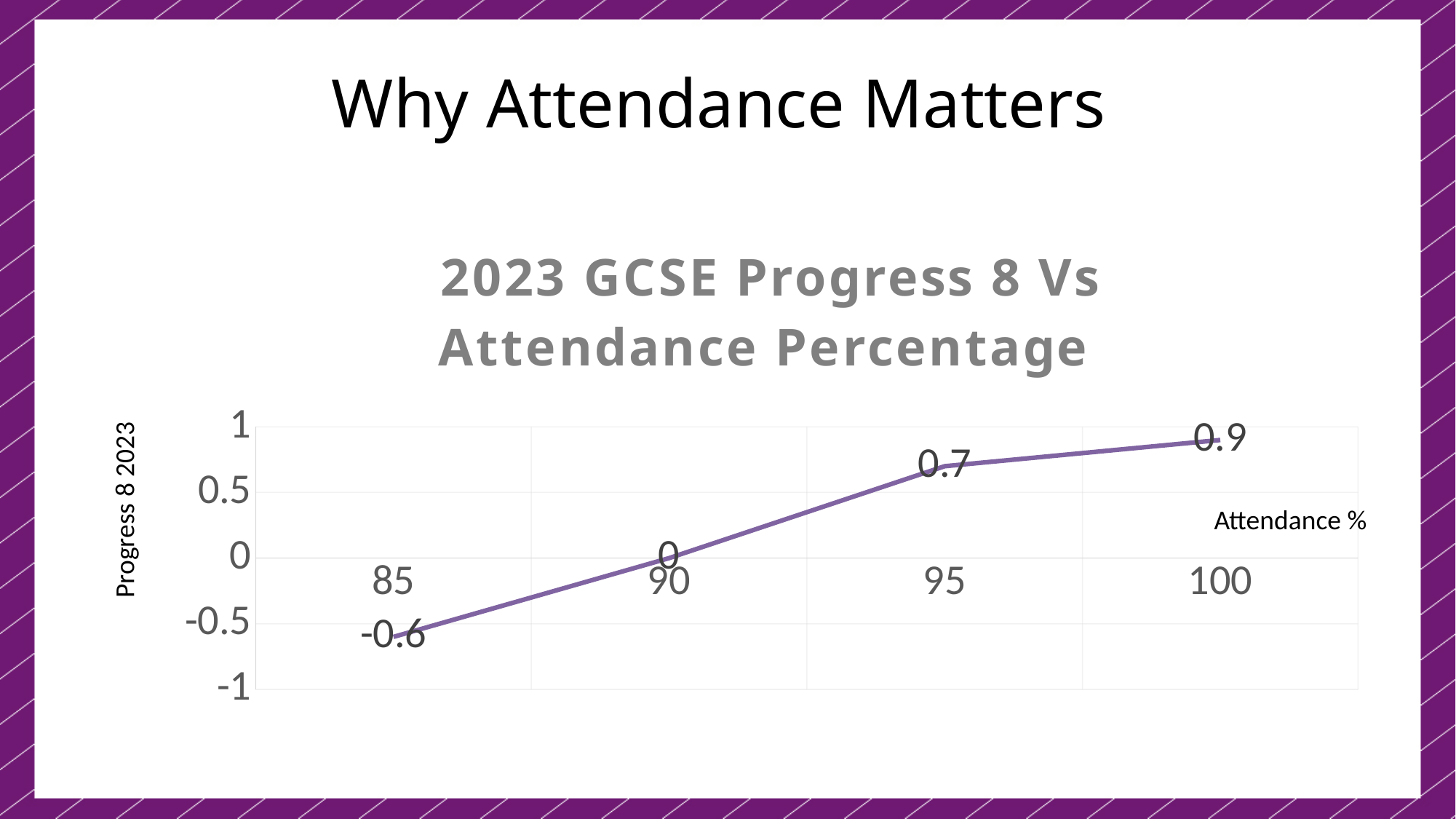
What kind of chart is shown on the slide? Line chart What is the difference between the Progress 8 values at 95% and 90% attendance? 0.7 Which attendance percentage has the lowest Progress 8 value? 85 Which has a larger Progress 8 value, 90% attendance or 95% attendance? 95 What is the difference between the Progress 8 values at 100% and 85% attendance? 1.5 Do the Progress 8 values rise or fall as attendance percentage increases? Rise What is the Progress 8 value at 95% attendance? 0.7 What is the Progress 8 value at 85% attendance? -0.6 Which attendance percentage has the highest Progress 8 value? 100 What is the Progress 8 value at 90% attendance? 0 What is the Progress 8 value at 100% attendance? 0.9 How many data points are plotted on the chart? 4